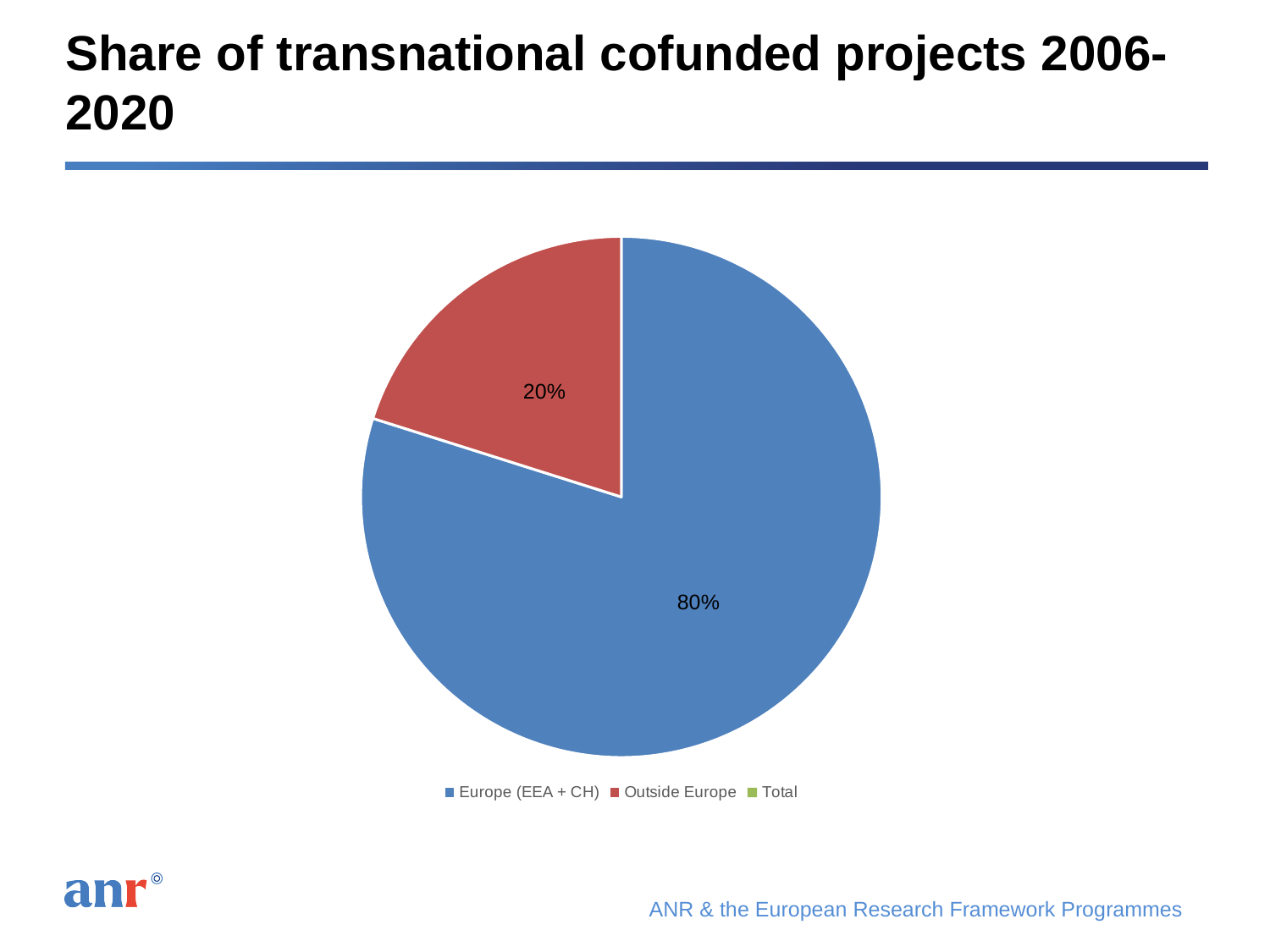
Which slice of the pie is the largest? Europe (EEA + CH) What share of the pie does Europe (EEA + CH) account for? 80% Which is larger, the Europe (EEA + CH) slice or the Outside Europe slice? Europe (EEA + CH) What colour is the Outside Europe slice? red Which visible slice of the pie is the smallest? Outside Europe What is the difference in percentage points between the Europe (EEA + CH) slice and the Outside Europe slice? 60 What share of the pie does Outside Europe account for? 20% How many entries does the legend list? 3 What kind of chart is shown on the slide? pie chart How many slices are visible in the pie? 2 What is the title of the slide containing the chart? Share of transnational cofunded projects 2006-2020